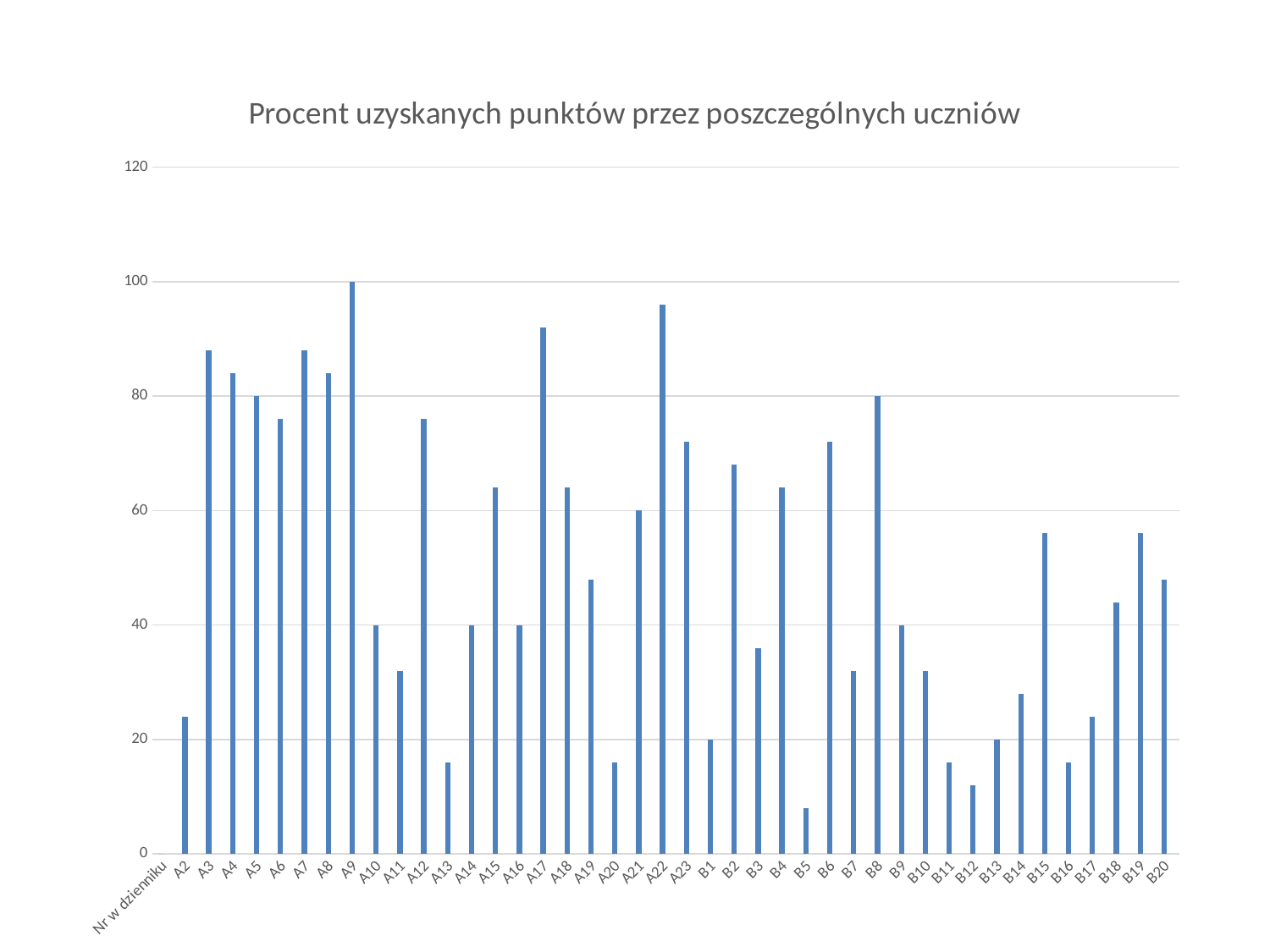
What is the value for B8? 80 What is the title of the chart? Procent uzyskanych punktów przez poszczególnych uczniów Which student has the highest percentage of points? A9 What is the value for A5? 80 Which is larger, the value for A22 or the value for A23? A22 What is the value for B1? 20 What is the value for A21? 60 Is the value for B12 greater or less than 20? less What is the value for A9? 100 What kind of chart is shown on the slide? bar chart Is the value for A22 greater or less than 80? greater Which student has the lowest percentage of points? B5